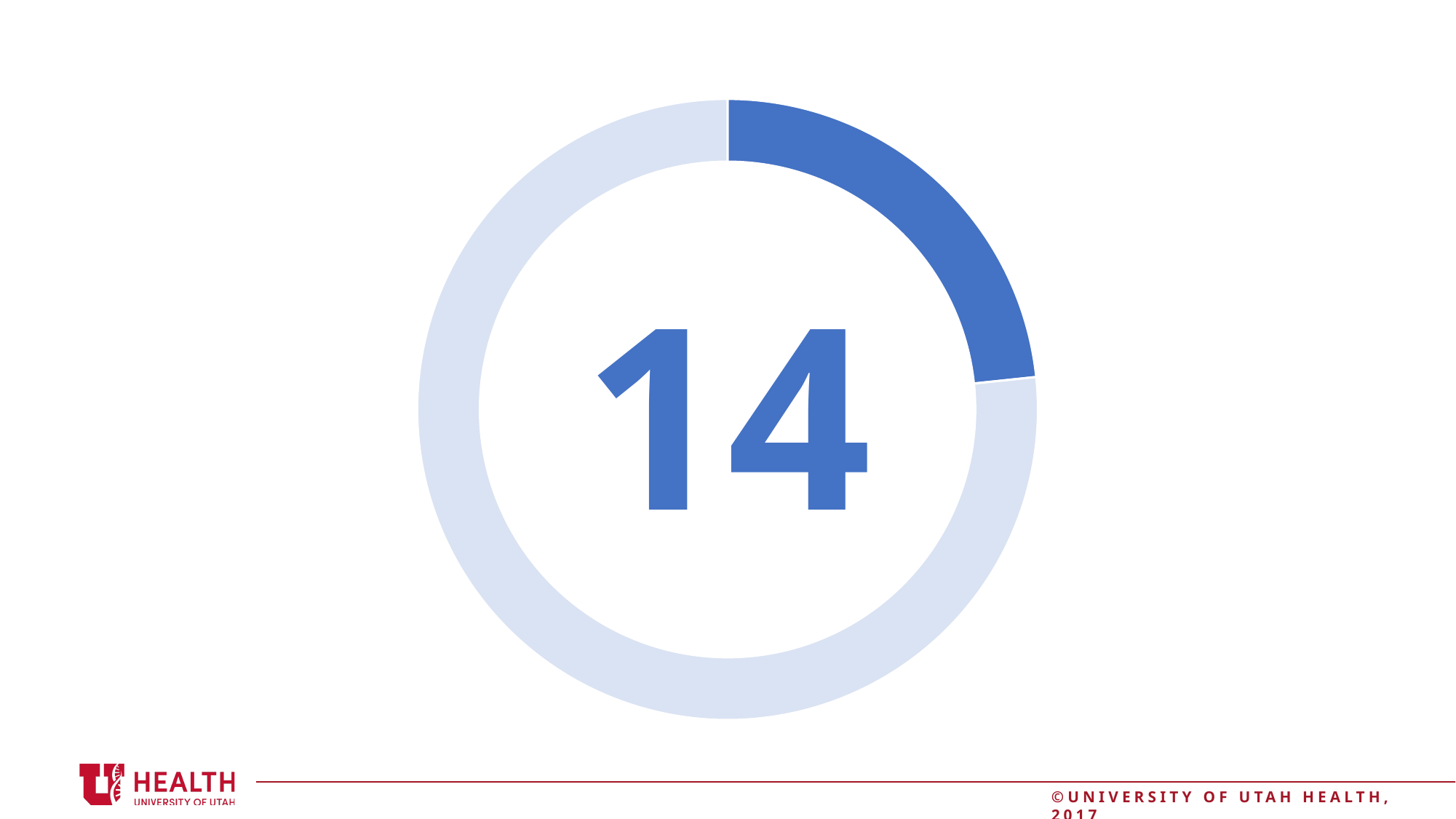
How many segments does the doughnut chart have? 2 What number is displayed in the centre of the doughnut chart? 14 What kind of chart is shown on the slide? Doughnut chart Does the doughnut chart display a legend? No Which segment of the doughnut chart is larger, the dark blue one or the light blue one? The light blue one Does the dark blue segment of the doughnut chart cover more or less than half of the ring? Less